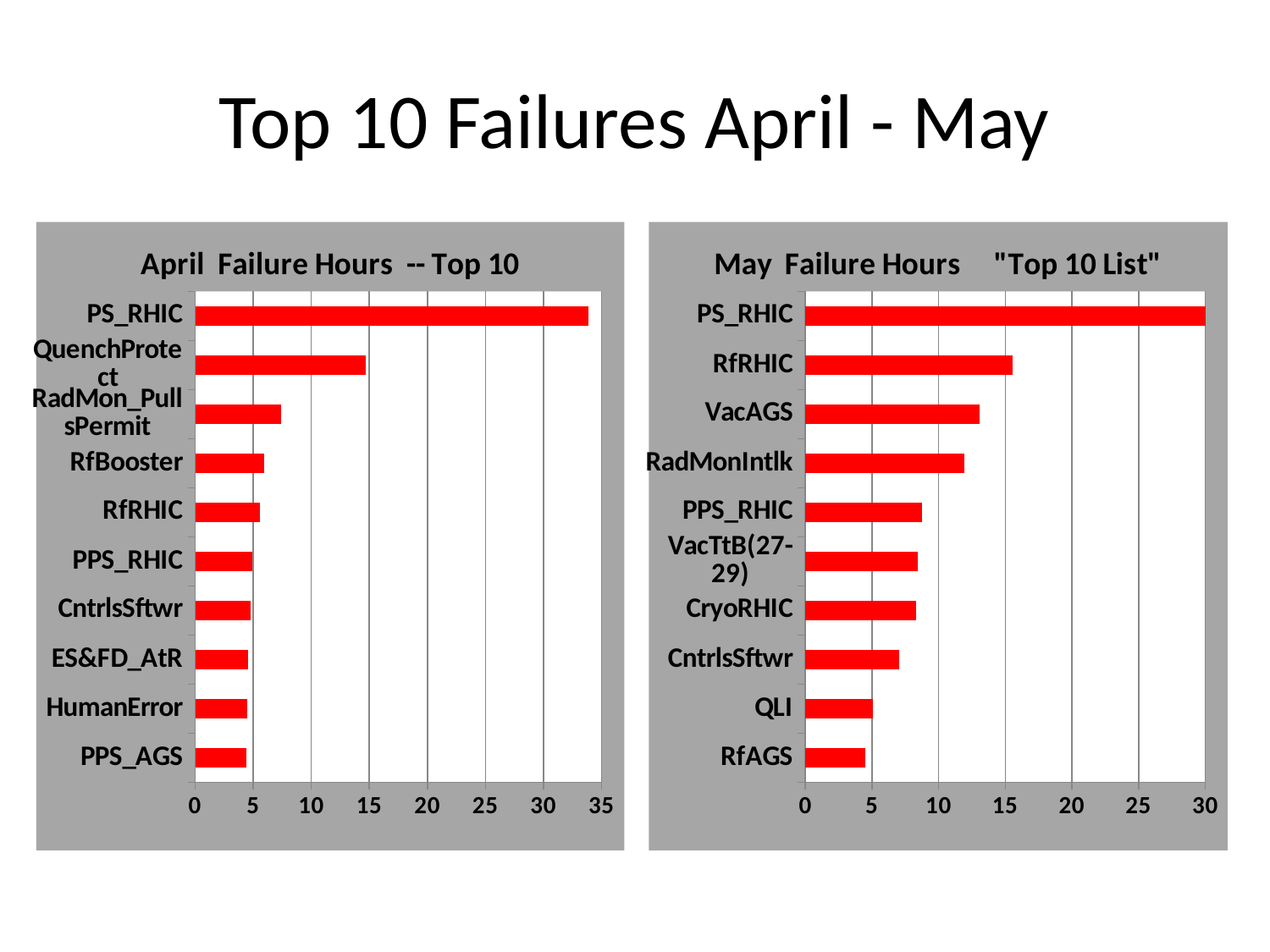
In the April Failure Hours -- Top 10 chart, which is larger, QuenchProtect or RadMon_PullsPermit? QuenchProtect In the May Failure Hours "Top 10 List" chart, which is larger, VacAGS or CntrlsSftwr? VacAGS In the April Failure Hours -- Top 10 chart, is the value for RfBooster greater or less than 10? less What kind of chart is the May Failure Hours "Top 10 List" chart? bar chart What colour are the bars in the April Failure Hours -- Top 10 chart? red In the April Failure Hours -- Top 10 chart, is the value for QuenchProtect greater or less than 10? greater In the April Failure Hours -- Top 10 chart, is the value for PS_RHIC greater or less than 30? greater In the May Failure Hours "Top 10 List" chart, which category has the highest value? PS_RHIC In the April Failure Hours -- Top 10 chart, which category has the highest value? PS_RHIC In the May Failure Hours "Top 10 List" chart, which category has the lowest value? RfAGS How many categories are shown in the April Failure Hours -- Top 10 chart? 10